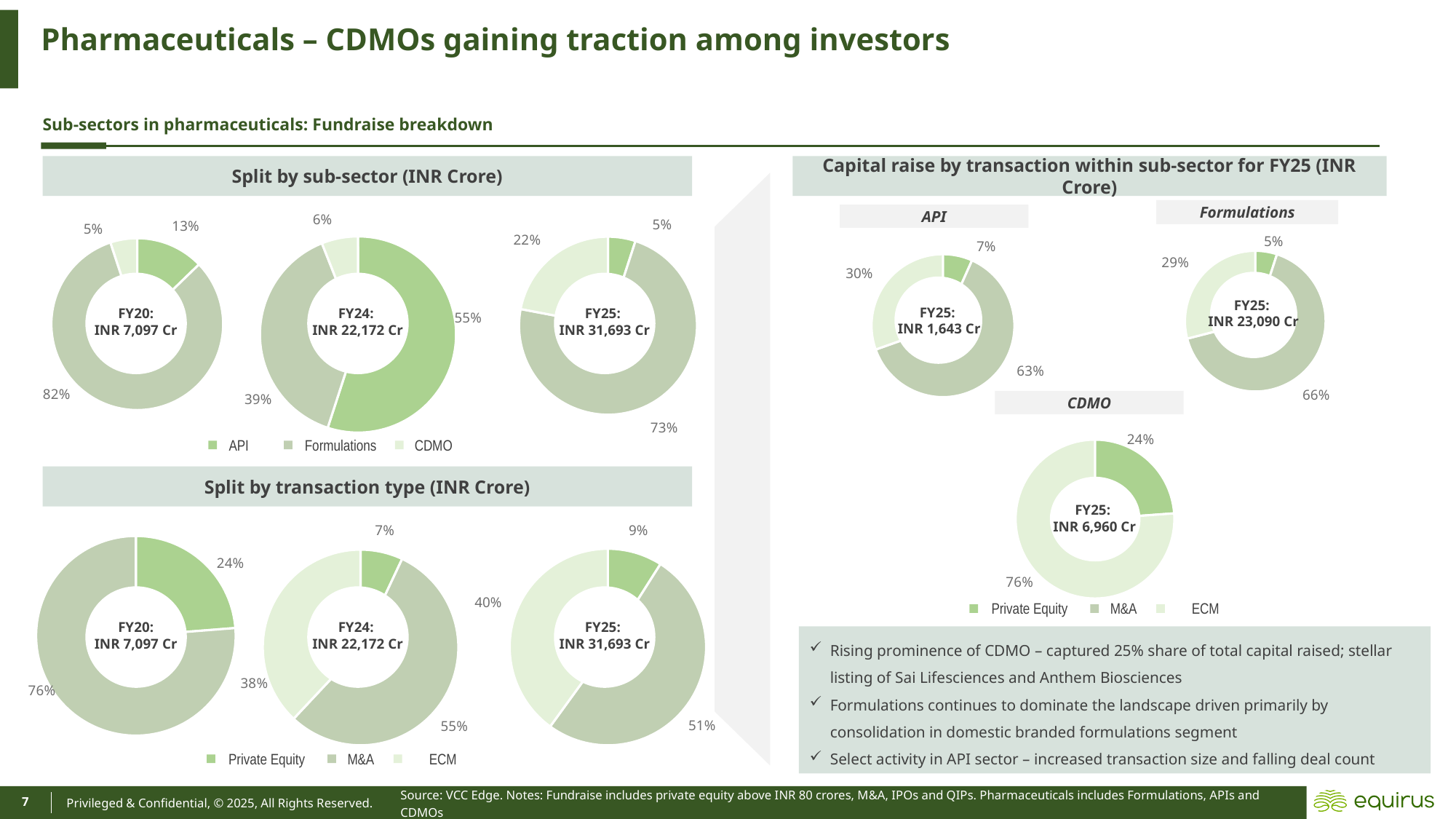
In the 'Split by transaction type (INR Crore)' chart, which transaction type has the smallest share in FY20? Private Equity What kind of chart is used throughout this slide to show the fundraise breakdowns? Donut (pie) chart In the 'Capital raise by transaction within sub-sector for FY25' chart, what share does ECM hold in the CDMO donut? 76% In the 'Split by sub-sector (INR Crore)' chart, what is the total fundraise shown in the centre of the FY25 donut? INR 31,693 Cr In the 'Capital raise by transaction within sub-sector for FY25' chart, what is the total capital raised shown for Formulations? INR 23,090 Cr In the 'Split by sub-sector (INR Crore)' chart, what share does Formulations hold in FY20? 82% In the 'Split by sub-sector (INR Crore)' chart, which sub-sector has the largest share in FY24? API In the 'Split by sub-sector (INR Crore)' chart, what share does CDMO hold in FY25? 22% In the 'Capital raise by transaction within sub-sector for FY25' chart, is the M&A share larger for API or for Formulations? Formulations In the 'Split by transaction type (INR Crore)' chart, what is the difference between the ECM share and the Private Equity share in FY24? 31% In the 'Split by sub-sector (INR Crore)' chart, how many sub-sectors does the legend list? 3